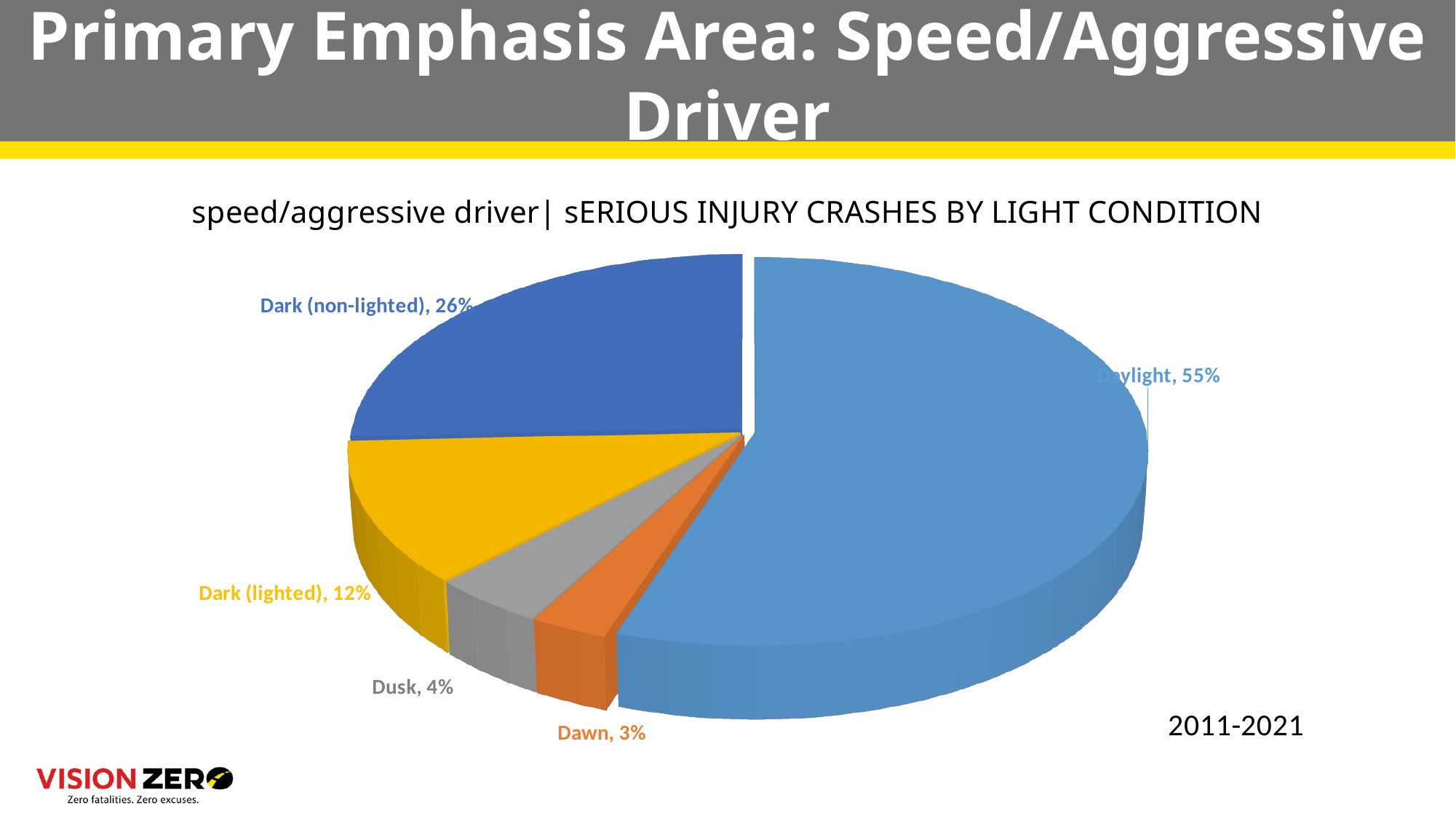
What share of serious injury crashes occurred in Dark (lighted) conditions? 12% What share of serious injury crashes occurred in Dark (non-lighted) conditions? 26% How many light condition categories are shown in the pie chart? 5 What is the difference in percentage points between the Daylight and Dark (non-lighted) shares? 29 Which has a larger share, Dark (lighted) or Dusk? Dark (lighted) What share of serious injury crashes occurred at Dusk? 4% What time period does the chart cover? 2011-2021 Which light condition has the largest share of serious injury crashes? Daylight What kind of chart is shown on the slide? Pie chart Which light condition has the smallest share of serious injury crashes? Dawn